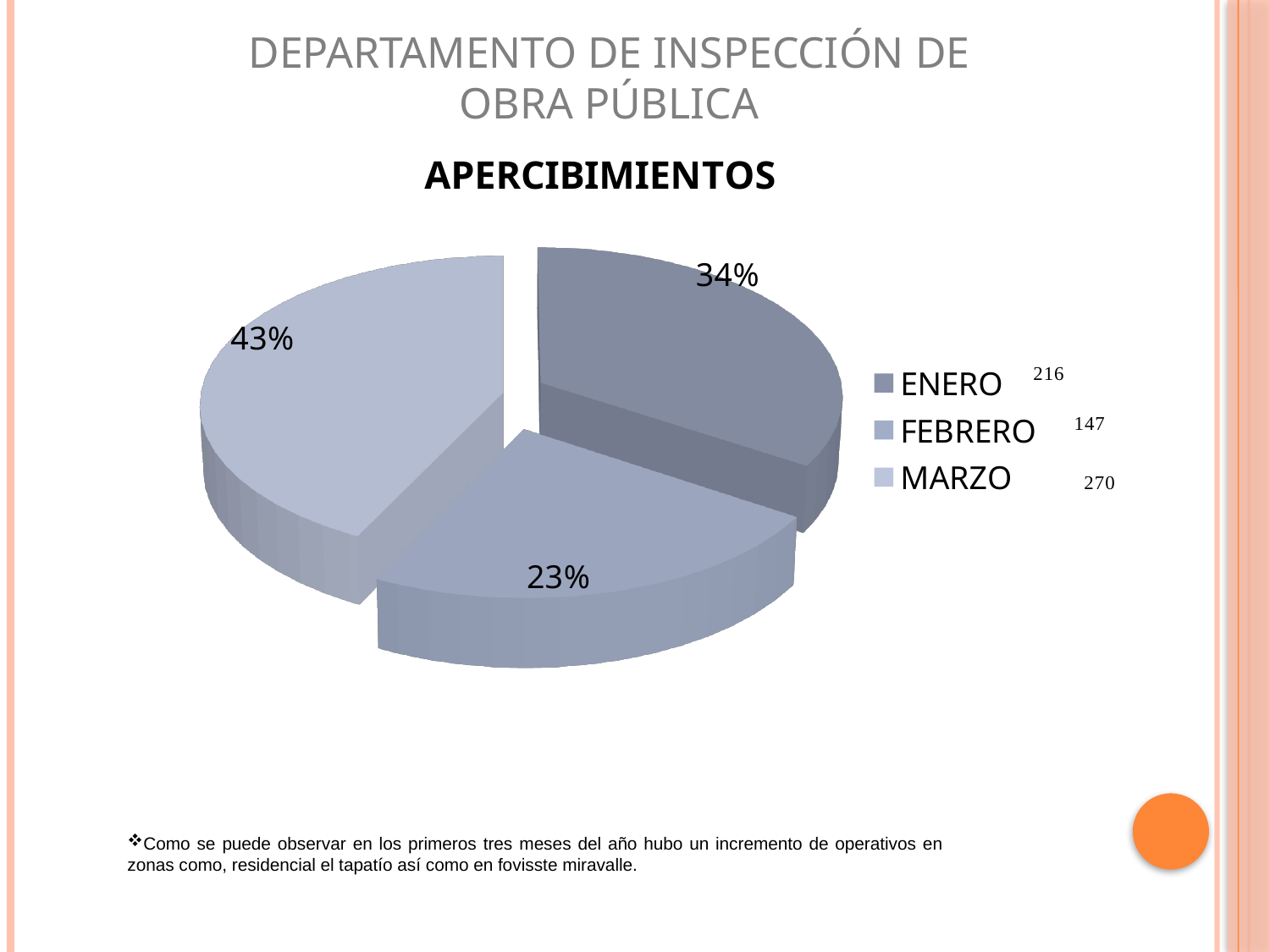
How many entries does the legend list? 3 Which is larger, the share for ENERO or the share for FEBRERO? ENERO How many slices does the pie chart have? 3 Which month has the largest slice of the pie? MARZO What number is shown next to ENERO in the legend? 216 What percentage share does the ENERO slice have? 34% What kind of chart is shown on the slide? pie chart What percentage share does the MARZO slice have? 43% What is the title of the chart? APERCIBIMIENTOS What percentage share does the FEBRERO slice have? 23% What number is shown next to MARZO in the legend? 270 Which month has the smallest slice of the pie? FEBRERO